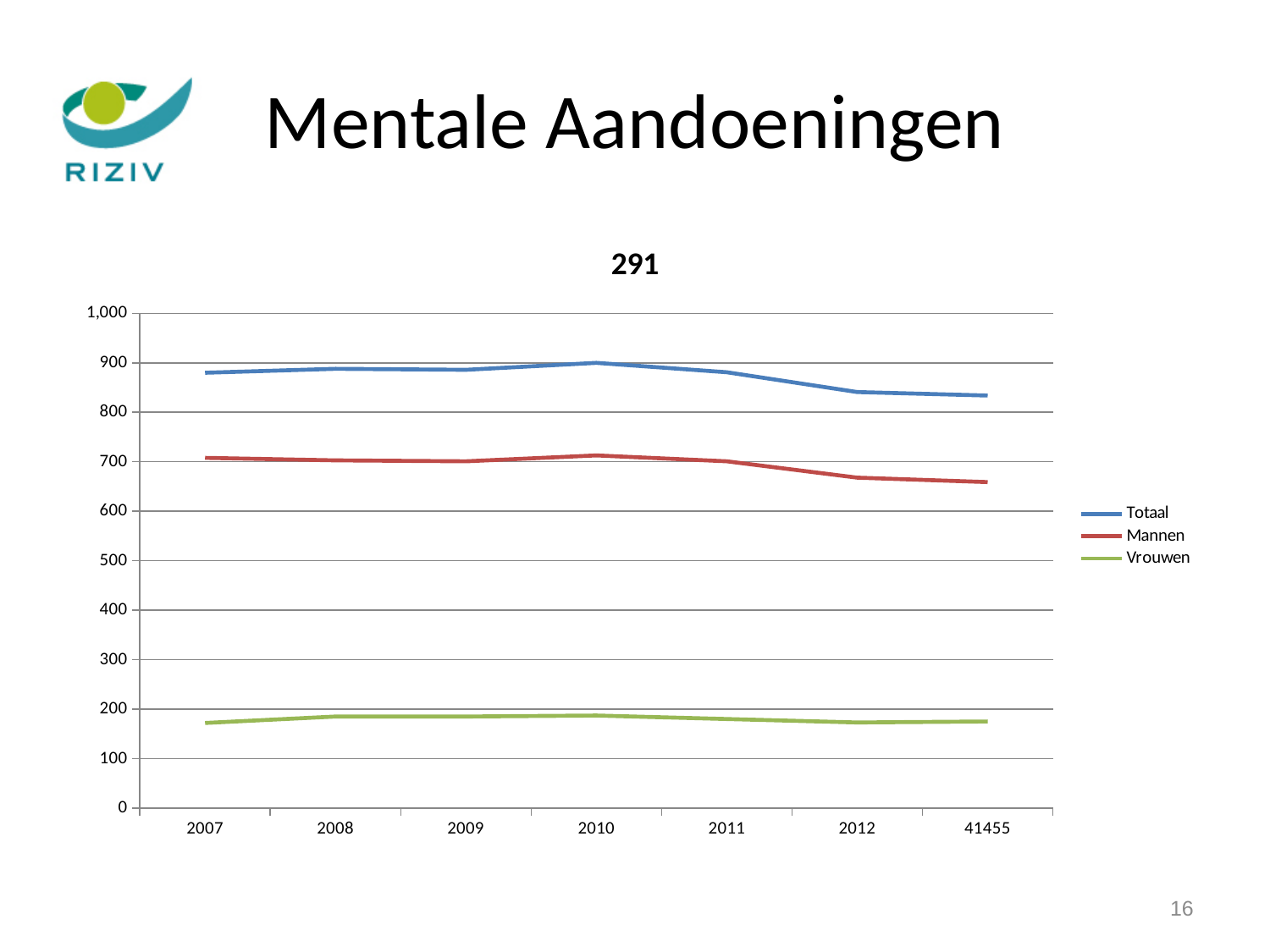
Is the value for Totaal in 2007 greater or less than 800? greater Is the value for Vrouwen in 2010 greater or less than 200? less Is the value for Mannen in 2012 greater or less than 700? less Which is larger in 2011, the value for Mannen or the value for Vrouwen? Mannen What kind of chart is shown on the slide? line chart Which is larger in 2009, the value for Totaal or the value for Mannen? Totaal What is the title of the chart? 291 Do the values for Totaal rise or fall from 2011 to the last point on the x axis? fall How many series does the legend list? 3 What colour is the line for Totaal? blue How many points are plotted along the x axis for each series? 7